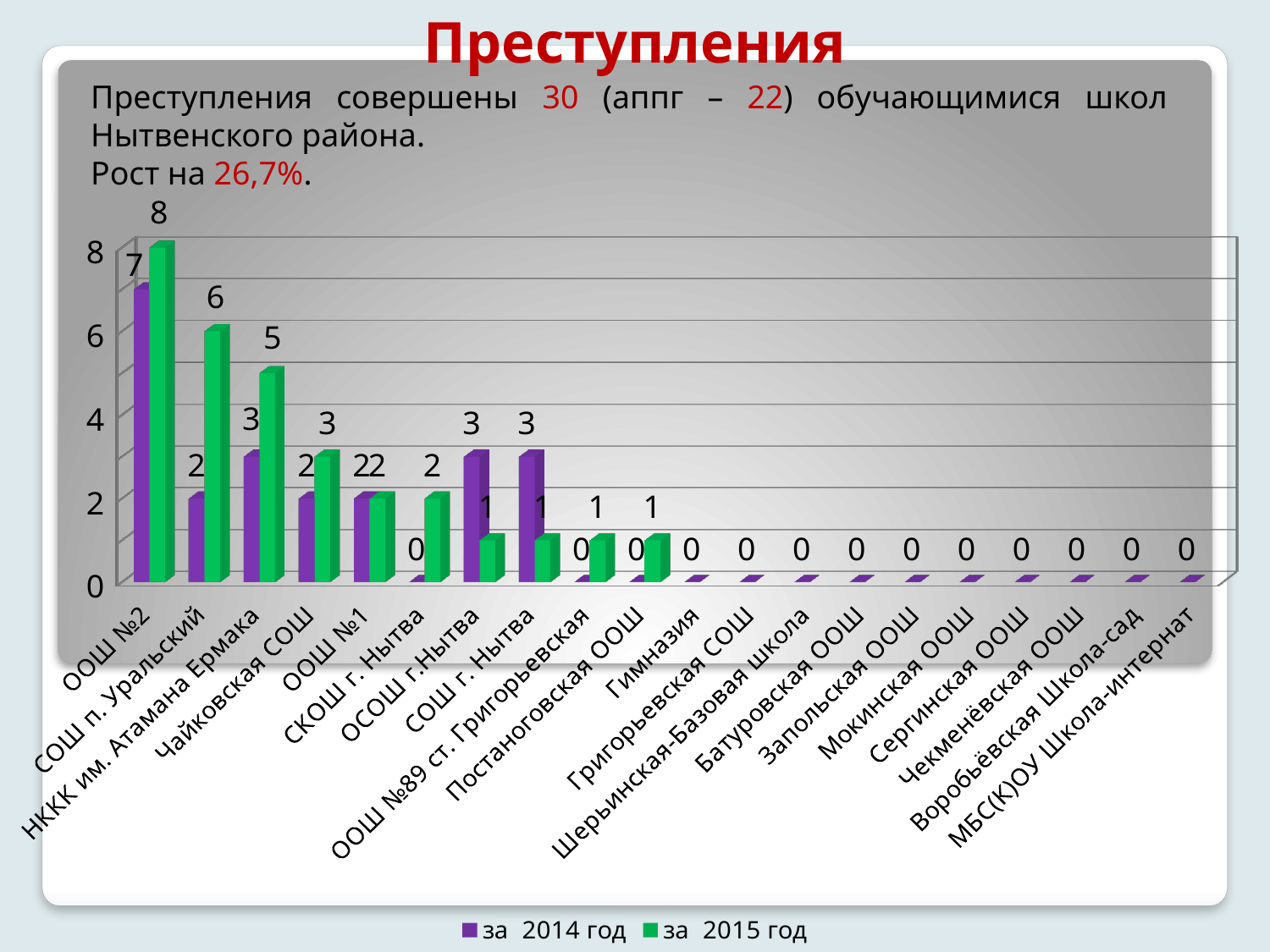
What is the difference between the 2015 and 2014 values for НККК им. Атамана Ермака? 2 What is the difference between the 2015 and 2014 values for ООШ №2? 1 What are the two legend entries of the chart? за 2014 год, за 2015 год What kind of chart is shown on the slide? bar chart What is the value for ООШ №2 in the series 'за 2015 год'? 8 Which category has the highest value in the series 'за 2015 год'? ООШ №2 What is the value for СОШ п. Уральский in the series 'за 2015 год'? 6 What is the value for СКОШ г. Нытва in the series 'за 2014 год'? 0 For СОШ п. Уральский, which series has the larger value: 'за 2014 год' or 'за 2015 год'? за 2015 год How many series does the legend list? 2 How many categories are shown on the x axis? 20 What is the value for ОСОШ г.Нытва in the series 'за 2014 год'? 3